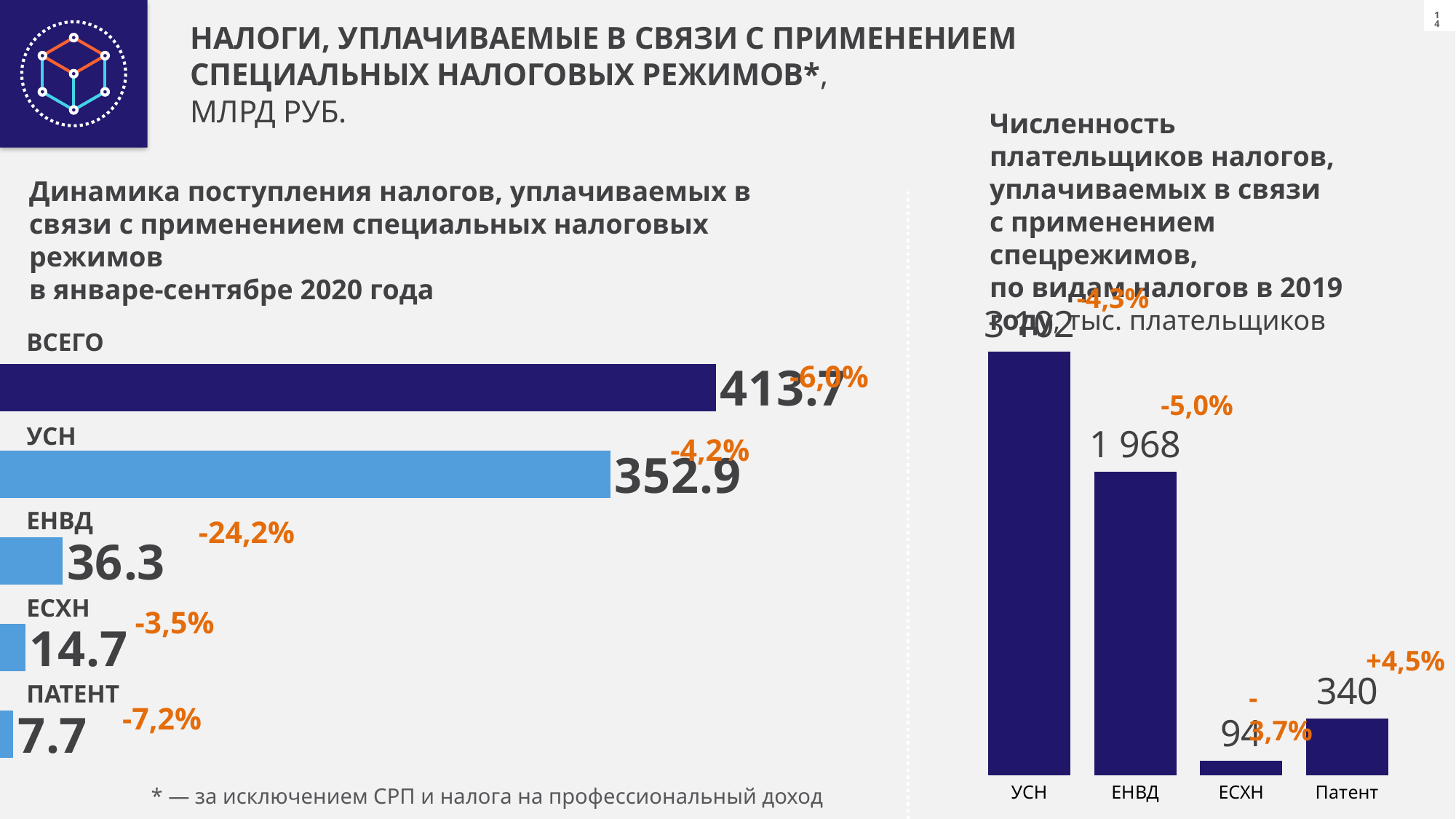
On the right chart (Численность плательщиков налогов), which category has the highest value? УСН On the left chart (Динамика поступления налогов), what is the value for ВСЕГО? 413.7 On the left chart (Динамика поступления налогов), what is the value for ЕНВД? 36.3 On the right chart (Численность плательщиков налогов), what is the value for ЕНВД? 1 968 On the left chart (Динамика поступления налогов), what percentage change is shown next to ЕНВД? -24,2% On the left chart (Динамика поступления налогов), what is the value for ПАТЕНТ? 7.7 On the right chart (Численность плательщиков налогов), what is the value for Патент? 340 On the left chart (Динамика поступления налогов), what is the value for УСН? 352.9 On the left chart (Динамика поступления налогов), which category has the lowest value? ПАТЕНТ On the left chart (Динамика поступления налогов), what kind of chart is it? Bar chart On the left chart (Динамика поступления налогов), what is the difference between the values for ЕНВД and ЕСХН? 21.6 On the left chart (Динамика поступления налогов), which category other than ВСЕГО has the highest value? УСН